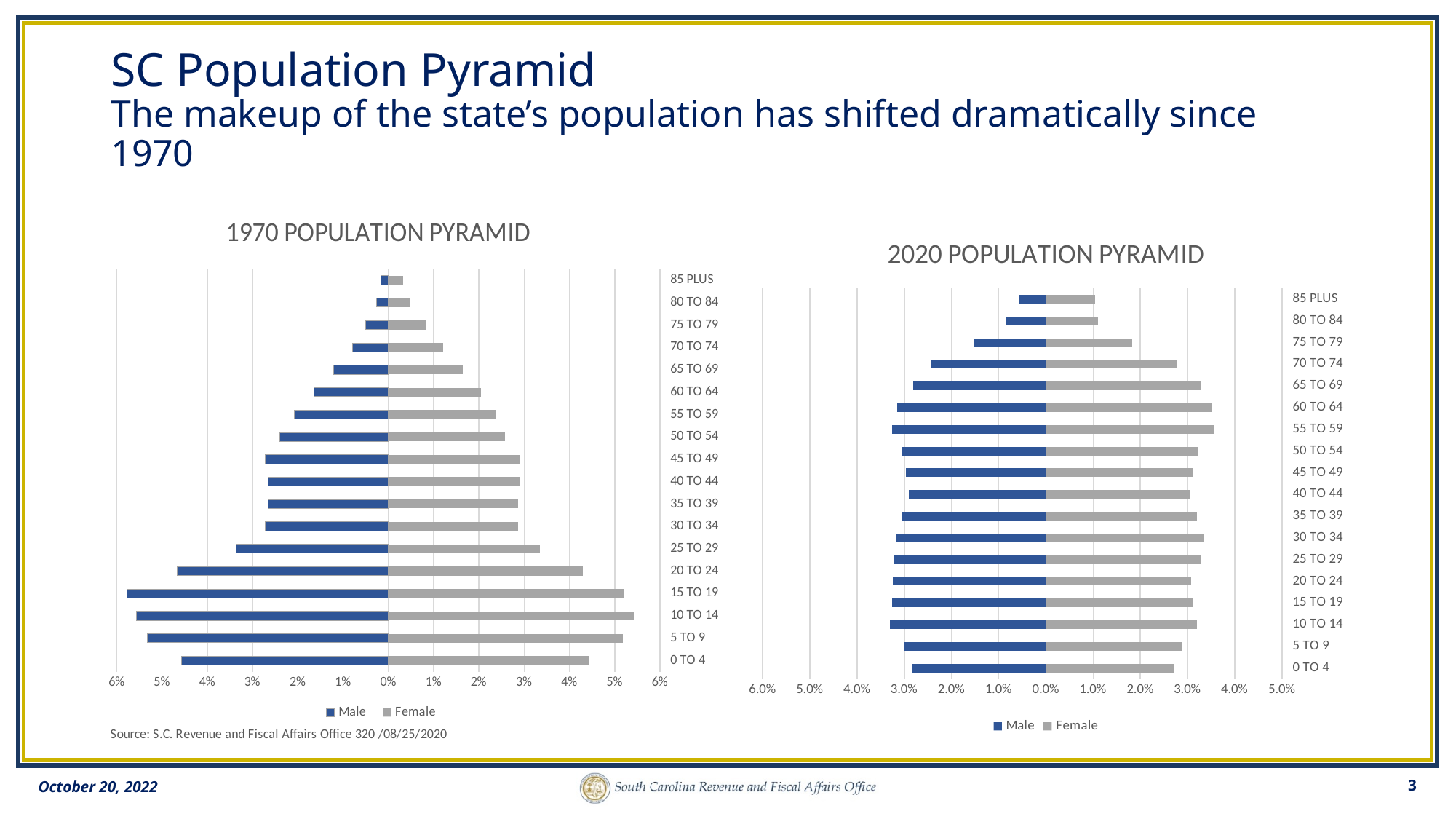
In the 1970 Population Pyramid, is the Male value for 15 to 19 greater or less than 5%? greater In the 1970 Population Pyramid, which Male value is larger, 20 to 24 or 25 to 29? 20 to 24 How many age groups are shown on the 1970 Population Pyramid? 18 In the 1970 Population Pyramid, which age group has the smallest Male value? 85 Plus How many series does the legend of the 2020 Population Pyramid list? 2 In the 1970 Population Pyramid, is the Male value for 85 Plus greater or less than 1%? less In the 1970 Population Pyramid, which is larger for the 85 Plus group, the Male value or the Female value? Female In the 2020 Population Pyramid, which is larger for the 85 Plus group, the Male value or the Female value? Female Which colour represents Female in the 2020 Population Pyramid? grey In the 2020 Population Pyramid, is the Female value for 70 to 74 greater or less than 3.0%? less What kind of chart is the 1970 Population Pyramid? bar chart